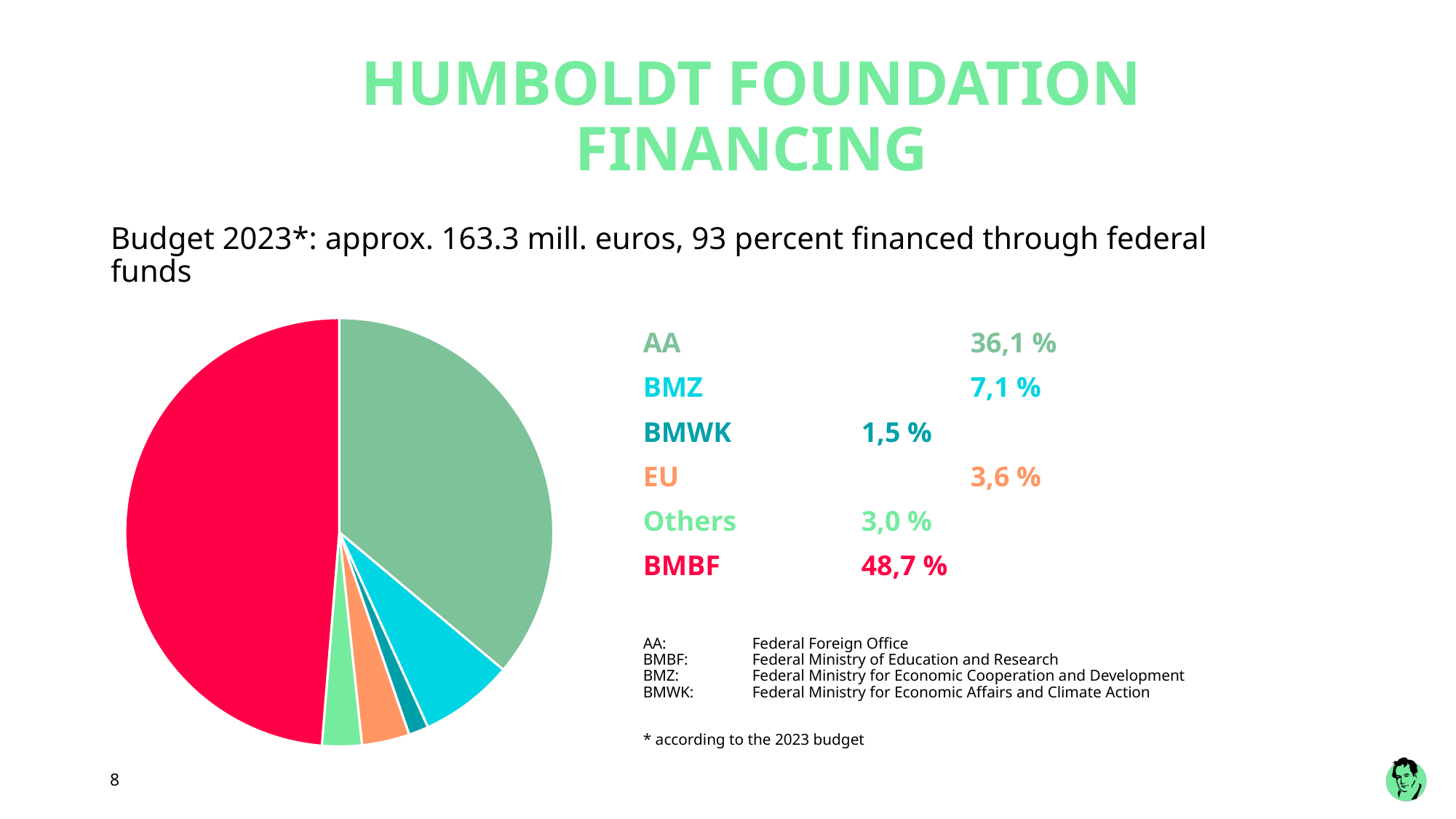
How many percentage points larger is the BMBF share than the AA share? 12,6 % Which is larger, the share for EU or the share for Others? EU What share of the financing comes from AA? 36,1 % What percentage is shown for EU? 3,6 % What type of chart is shown on the slide? Pie chart What is the difference between the BMZ share and the EU share? 3,5 % What percentage is shown for BMZ? 7,1 % What share of the Humboldt Foundation financing comes from BMBF? 48,7 % What colour is the BMBF slice of the pie chart? Red Which source has the smallest share of the financing? BMWK How many funding sources are shown in the pie chart? 6 Which source has the largest share of the financing? BMBF